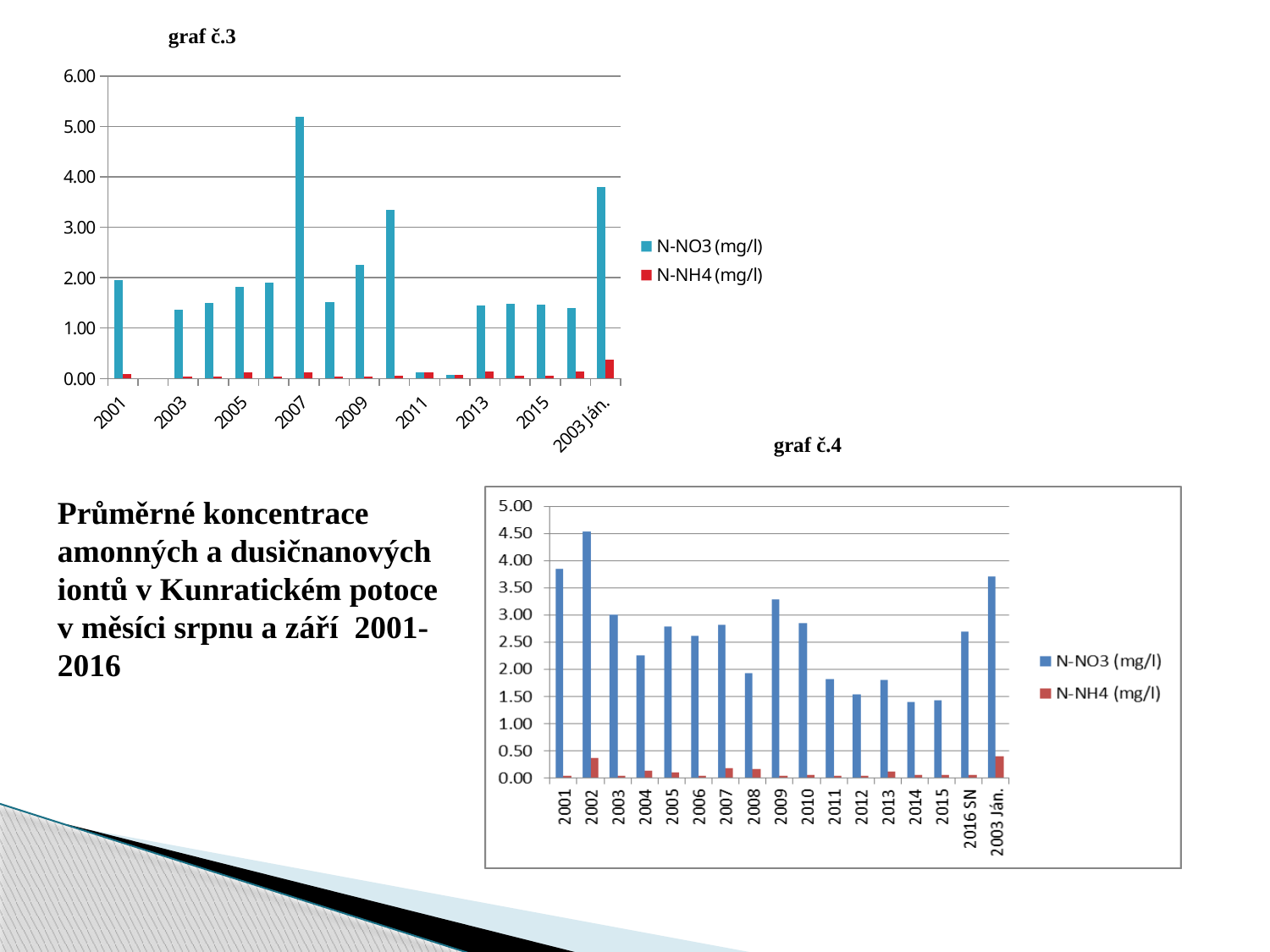
In graf č.4 (bottom chart), which series is shown in red? N-NH4 (mg/l) In graf č.4 (bottom chart), is the N-NO3 (mg/l) value for 2002 greater or less than 4.00? greater How many categories are shown on the x axis of graf č.4 (bottom chart)? 17 In graf č.3 (top chart), is the N-NO3 (mg/l) value for 2007 greater or less than 5.00? greater In graf č.4 (bottom chart), which category has the highest N-NO3 (mg/l) value? 2002 In graf č.4 (bottom chart), which is larger, the N-NO3 (mg/l) value for 2009 or for 2011? 2009 How many series does the legend of graf č.3 (top chart) list? 2 In graf č.3 (top chart), which category has the highest N-NO3 (mg/l) value? 2007 In graf č.4 (bottom chart), is the N-NO3 (mg/l) value for 2012 greater or less than 2.00? less In graf č.3 (top chart), which is larger, the N-NO3 (mg/l) value for 2007 or for 2009? 2007 What kind of chart is graf č.4 (bottom chart)? bar chart